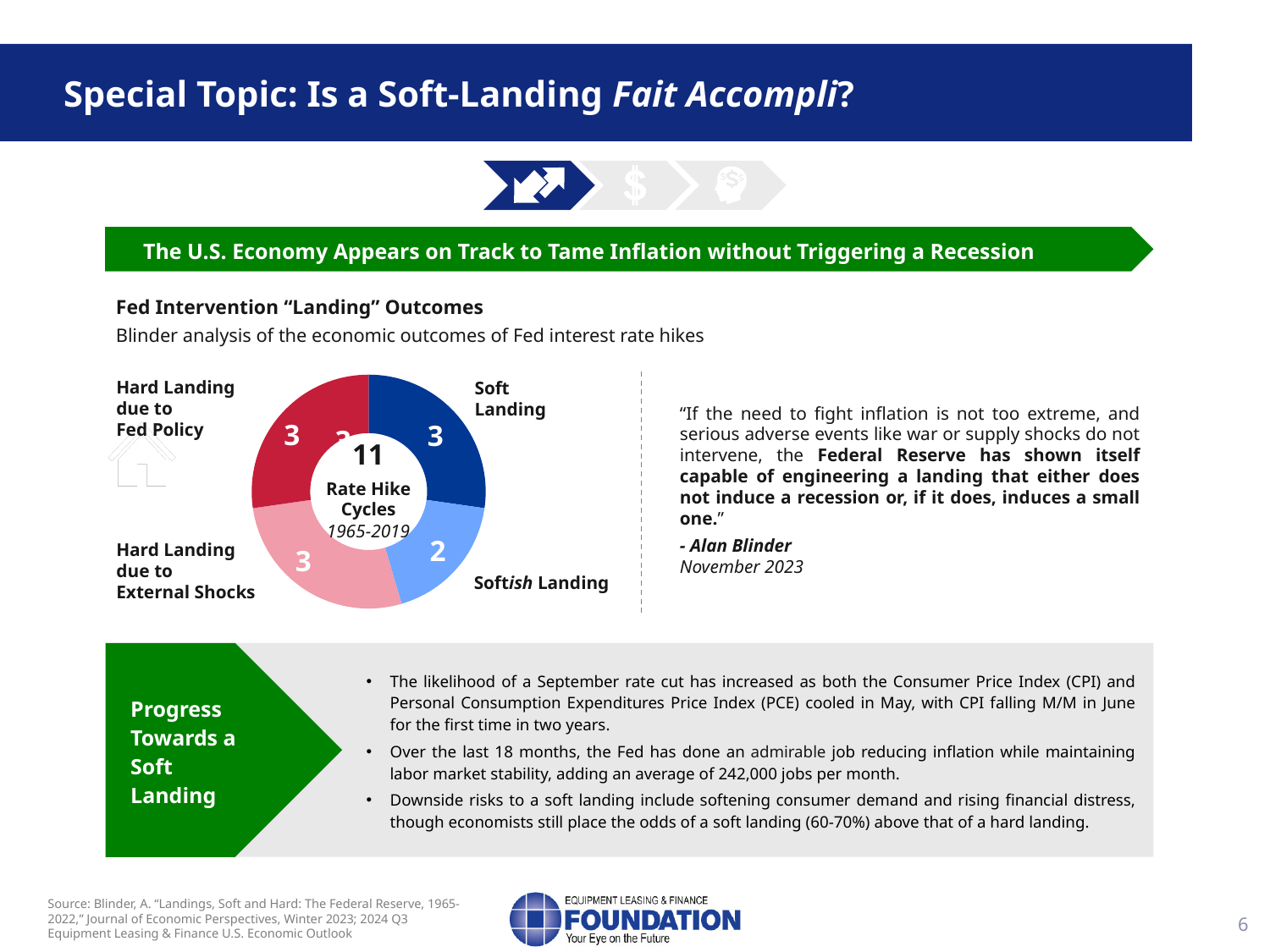
What is the difference between the Soft Landing count and the Softish Landing count? 1 How many landing outcome categories are shown in the donut chart? 4 Which landing outcome has the lowest count in the donut chart? Softish Landing What time period does the donut chart cover, as shown in its center? 1965-2019 What is the title of the chart on the slide? Fed Intervention "Landing" Outcomes What is the value for Softish Landing in the donut chart? 2 What is the value for Soft Landing in the donut chart? 3 What is the value for Hard Landing due to External Shocks in the donut chart? 3 What is the value for Hard Landing due to Fed Policy in the donut chart? 3 What kind of chart is shown under "Fed Intervention "Landing" Outcomes"? Donut (pie) chart How many rate hike cycles does the donut chart cover in total? 11 Which is larger in the donut chart: Soft Landing or Softish Landing? Soft Landing